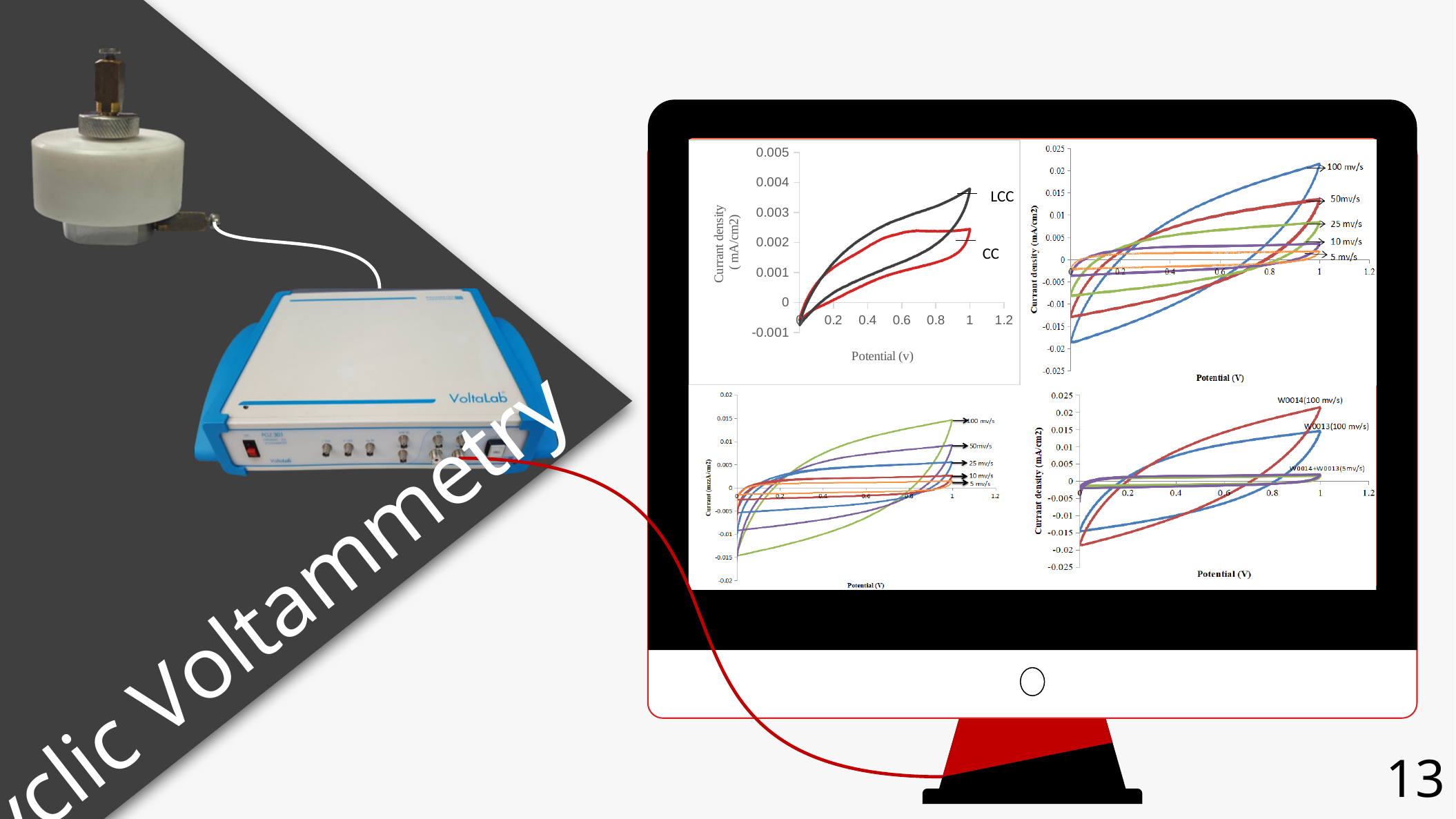
What kind of chart is the top-left chart on the monitor (the one labelled LCC and CC)? line chart In the bottom-right chart on the monitor, how many curves are labelled? 3 In the top-right chart on the monitor, is the peak current density of the 100 mv/s curve greater or less than 0.015? greater In the top-left chart on the monitor, is the maximum current density of the LCC curve greater or less than 0.003? greater In the top-right chart on the monitor, how many scan rates are labelled? 5 In the top-left chart on the monitor, which curve reaches the higher current density, LCC or CC? LCC In the top-left chart on the monitor, is the maximum current density of the CC curve greater or less than 0.003? less In the top-left chart on the monitor, how many curves are labelled? 2 What is the y-axis label of the top-right chart on the monitor? Currant density (mA/cm2) What is the x-axis label of the top-left chart on the monitor? Potential (v) In the top-right chart on the monitor, which scan rate produces the largest loop? 100 mv/s In the bottom-right chart on the monitor, which curve reaches the higher current density, W0014(100 mv/s) or W0013(100 mv/s)? W0014(100 mv/s)